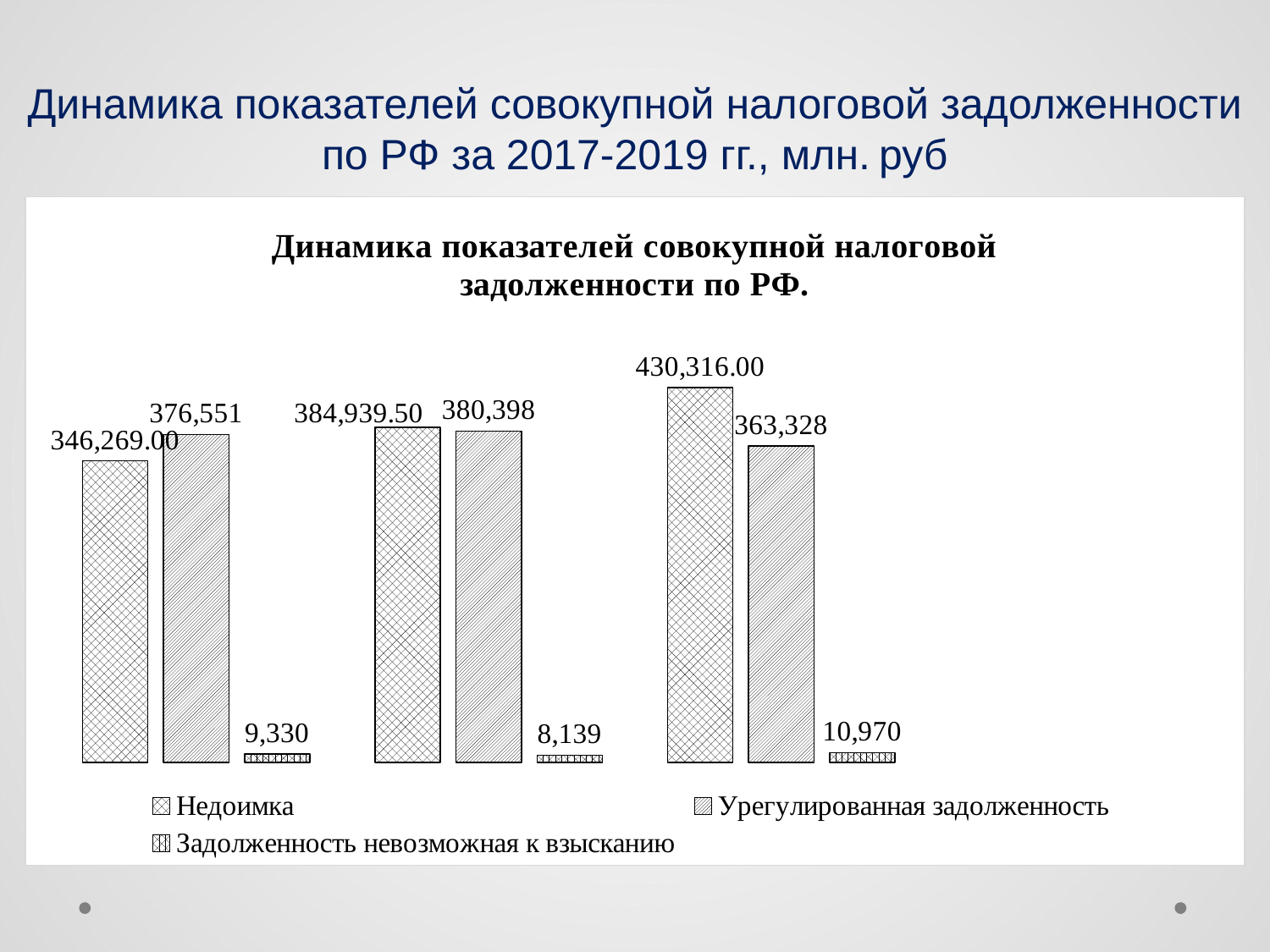
What is the difference between Недоимка (430,316.00) and Урегулированная задолженность (363,328) in the third group? 66,988 In which group of bars is Недоимка the highest? the third (rightmost) group What kind of chart is shown on the slide? bar chart What is the value of Урегулированная задолженность in the first (leftmost) group of bars? 376,551 What is the value of Недоимка in the third (rightmost) group of bars? 430,316.00 What is the value of Задолженность невозможная к взысканию in the second (middle) group of bars? 8,139 How many groups of bars are plotted in the chart? 3 How many series does the legend list? 3 In the first (leftmost) group of bars, which is larger: Недоимка or Урегулированная задолженность? Урегулированная задолженность Does the value of Недоимка rise or fall from the first group to the third group? rises In which group of bars is Задолженность невозможная к взысканию the lowest? the second (middle) group What is the difference between Задолженность невозможная к взысканию in the third group (10,970) and in the second group (8,139)? 2,831